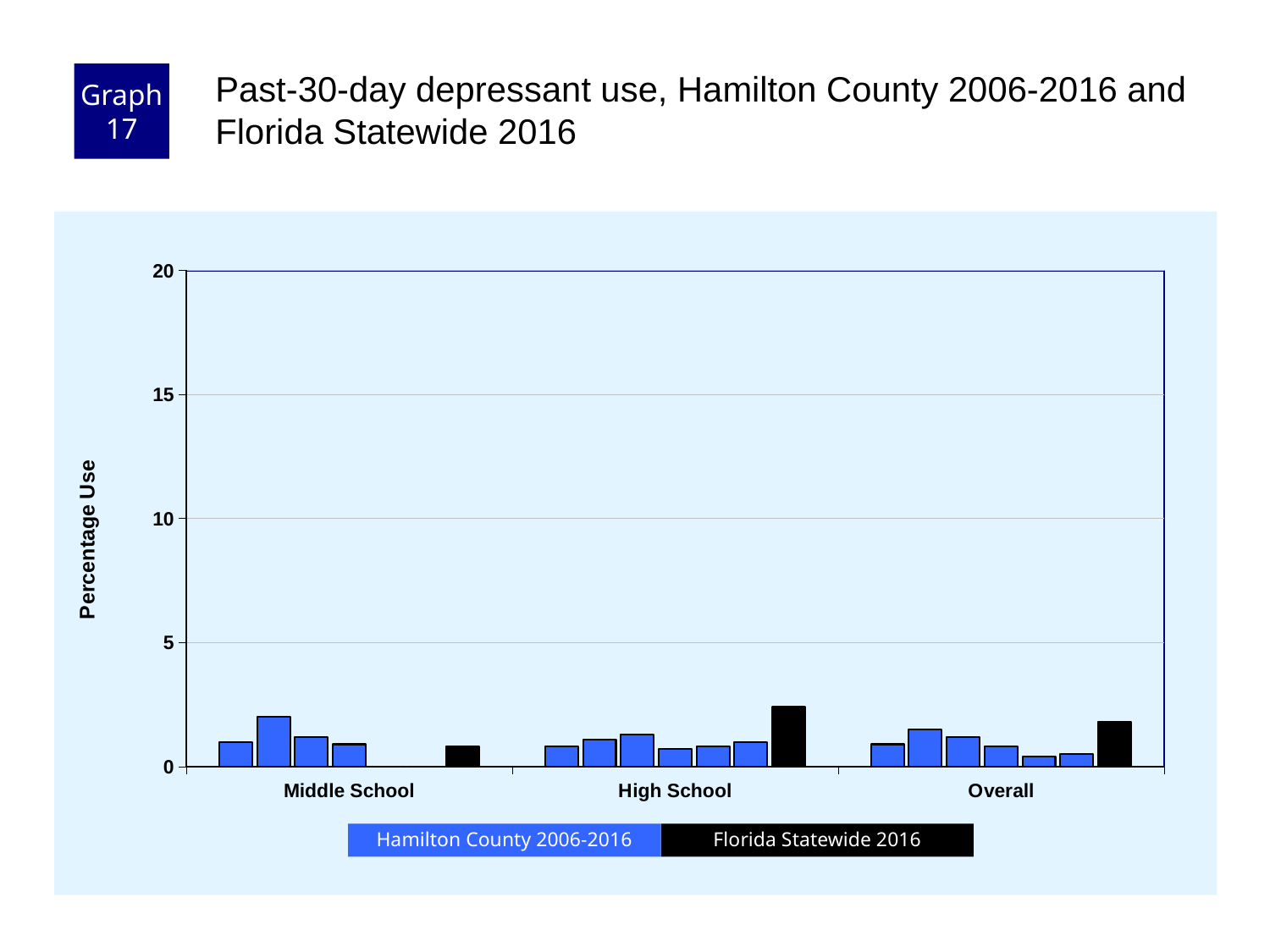
What is the label on the vertical axis? Percentage Use Is the Florida Statewide 2016 value for Middle School greater or less than 5? less Which category has the lowest Florida Statewide 2016 value? Middle School Is the Florida Statewide 2016 value larger for High School or for Middle School? High School How many series does the legend list? 2 What kind of chart is shown on the slide? bar chart Is the Florida Statewide 2016 value for High School greater or less than 5? less Is the Florida Statewide 2016 value for Overall greater or less than 10? less Is the Florida Statewide 2016 value larger for Overall or for Middle School? Overall Which category has the highest Florida Statewide 2016 value? High School How many category groups are shown on the x axis? 3 What is the title of the chart? Past-30-day depressant use, Hamilton County 2006-2016 and Florida Statewide 2016